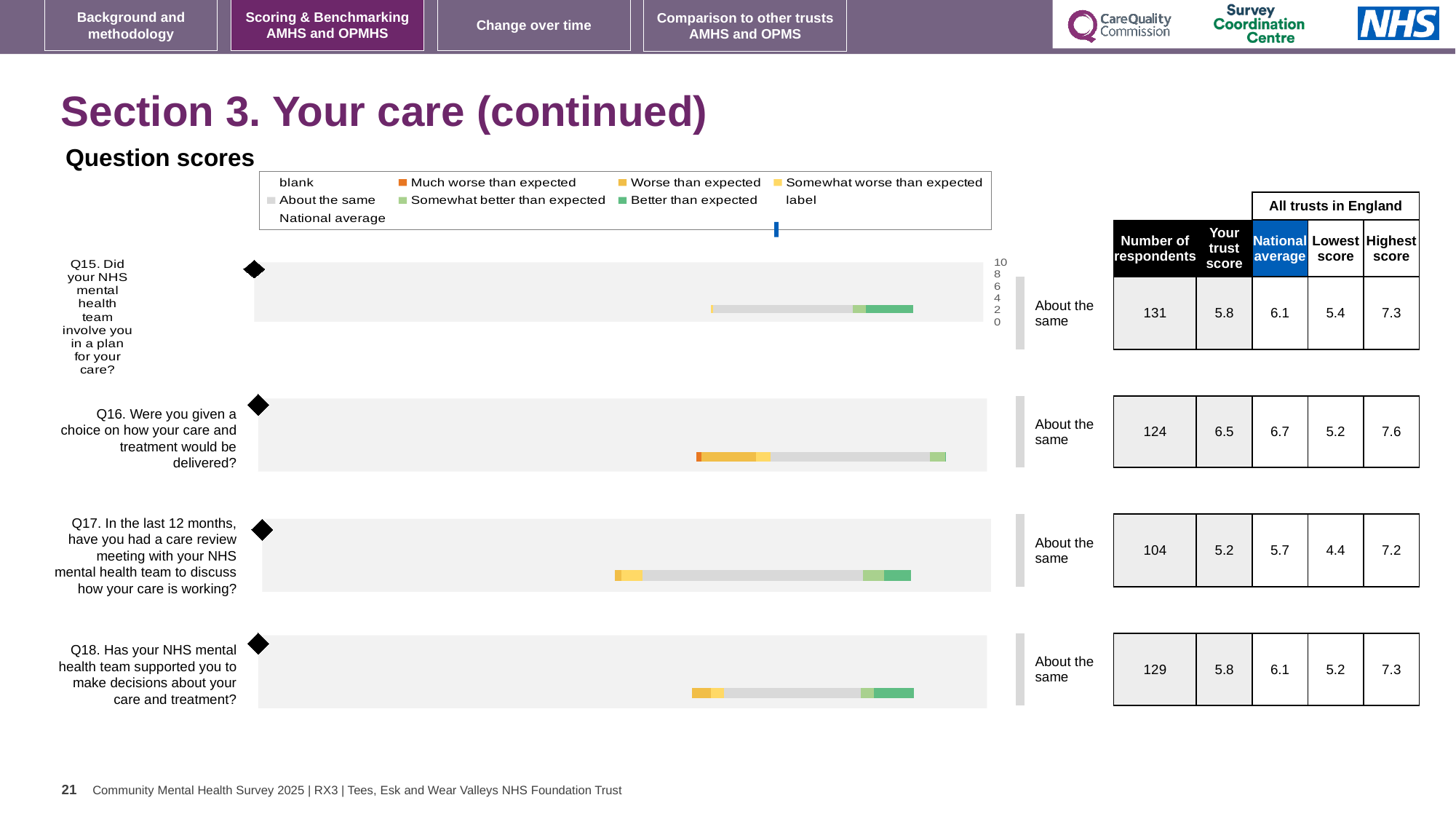
What is the difference between the national average and the trust score for Q17? 0.5 What is the lowest score across all trusts in England for Q17? 4.4 What is the highest score across all trusts in England for Q18 (supported you to make decisions about your care and treatment)? 7.3 What benchmark category is shown for Q18? About the same What type of chart is used to display the question scores on this slide? bar chart How many questions (Q15 to Q18) are plotted on this slide? 4 For Q16, which is larger: the trust score or the national average? National average What is the national average for Q16 (Were you given a choice on how your care and treatment would be delivered?)? 6.7 Which question has the highest trust score among Q15 to Q18? Q16 Which question has the lowest trust score among Q15 to Q18? Q17 How many respondents answered Q17 (care review meeting in the last 12 months)? 104 What is the trust score for Q15 (Did your NHS mental health team involve you in a plan for your care?)? 5.8